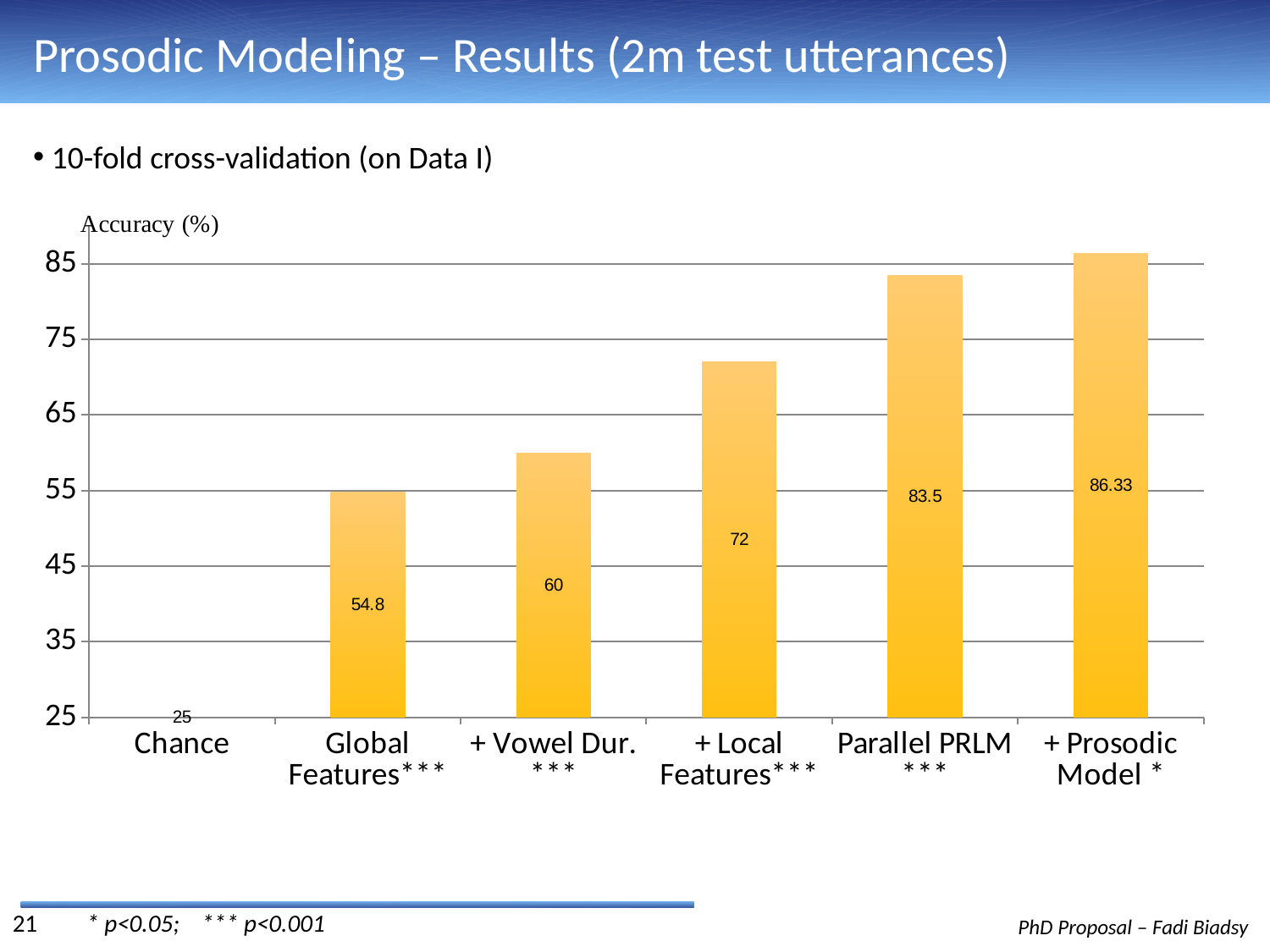
What is the accuracy value for Global Features***? 54.8 Which category has the lowest accuracy? Chance What is the difference in accuracy between + Prosodic Model * and Parallel PRLM ***? 2.83 What is the accuracy value for Parallel PRLM ***? 83.5 What is the difference in accuracy between + Local Features*** and + Vowel Dur. ***? 12 What kind of chart is shown on the slide? Bar chart What is the accuracy value for + Prosodic Model *? 86.33 Which has a higher accuracy, + Vowel Dur. *** or Global Features***? + Vowel Dur. *** How many categories are shown on the x axis? 6 Do the accuracy values rise or fall from left to right along the x axis? Rise Which category has the highest accuracy? + Prosodic Model * What is the accuracy value for + Local Features***? 72